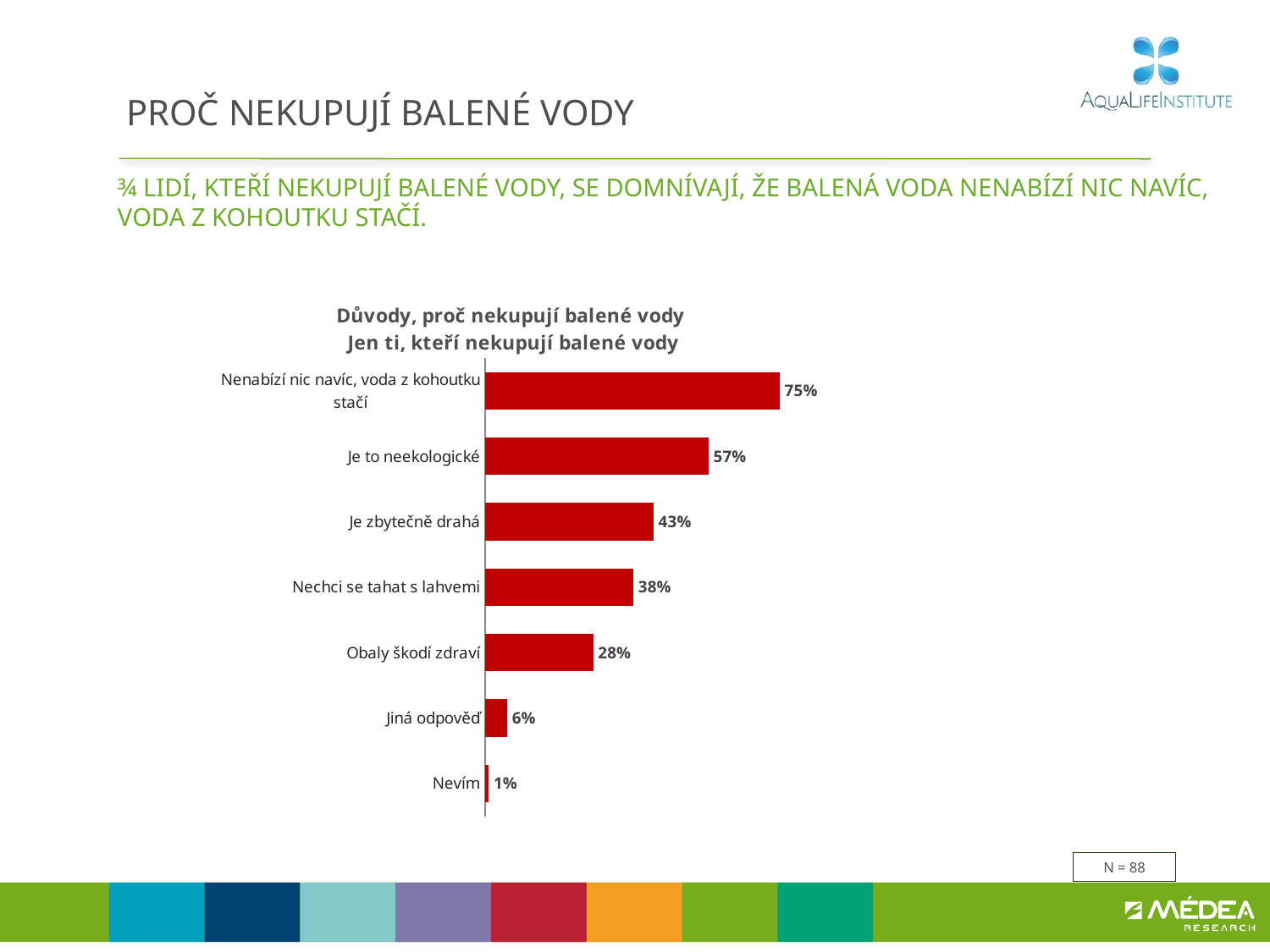
Which category has the highest value? Nenabízí nic navíc, voda z kohoutku stačí Which category has the lowest value? Nevím What is the difference between the values for "Je zbytečně drahá" and "Obaly škodí zdraví"? 15% What kind of chart is shown on the slide? Bar chart What is the value for "Nevím"? 1% How many categories are shown in the chart? 7 What is the value for "Je to neekologické"? 57% What is the title of the chart? Důvody, proč nekupují balené vody Jen ti, kteří nekupují balené vody What is the difference between the values for "Nenabízí nic navíc, voda z kohoutku stačí" and "Je to neekologické"? 18% Which is larger: the value for "Je zbytečně drahá" or the value for "Nechci se tahat s lahvemi"? Je zbytečně drahá What is the value for "Obaly škodí zdraví"? 28% What is the value for "Nechci se tahat s lahvemi"? 38%